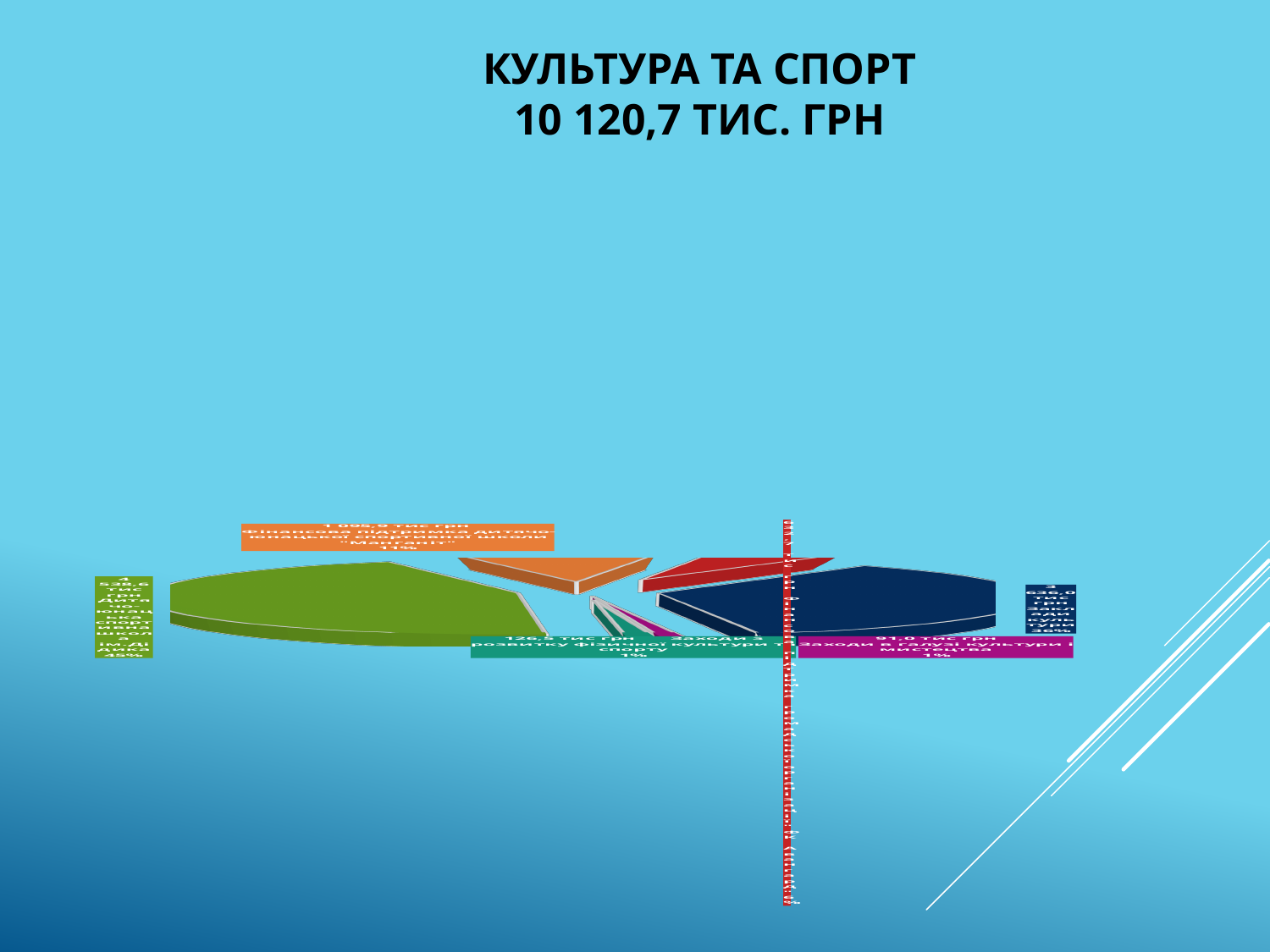
What share of the pie does "Заходи з розвитку фізичної культури та спорту" take? 1% What is the value for "Заходи в галузі культури і мистецтва"? 91,0 тис грн What kind of chart is shown on the slide? pie chart What is the title of the chart on the slide? КУЛЬТУРА ТА СПОРТ 10 120,7 ТИС. ГРН Which is larger: the value for "Фінансова підтримка дитячо-юнацької спортивної школи "Манганіт"" or for "Заходи з розвитку фізичної культури та спорту"? Фінансова підтримка дитячо-юнацької спортивної школи "Манганіт" What is the value for "Заходи з розвитку фізичної культури та спорту"? 126,5 тис грн What is the difference between the values for "Заходи з розвитку фізичної культури та спорту" and "Заходи в галузі культури і мистецтва"? 35,5 тис грн What share of the pie does "Фінансова підтримка дитячо-юнацької спортивної школи "Манганіт"" take? 11% What is the value for "Фінансова підтримка дитячо-юнацької спортивної школи "Манганіт""? 1 095,9 тис грн Which is larger: the value for "Заходи з розвитку фізичної культури та спорту" or for "Заходи в галузі культури і мистецтва"? Заходи з розвитку фізичної культури та спорту What total amount is stated in the chart title? 10 120,7 тис. грн What share of the pie does "Заходи в галузі культури і мистецтва" take? 1%